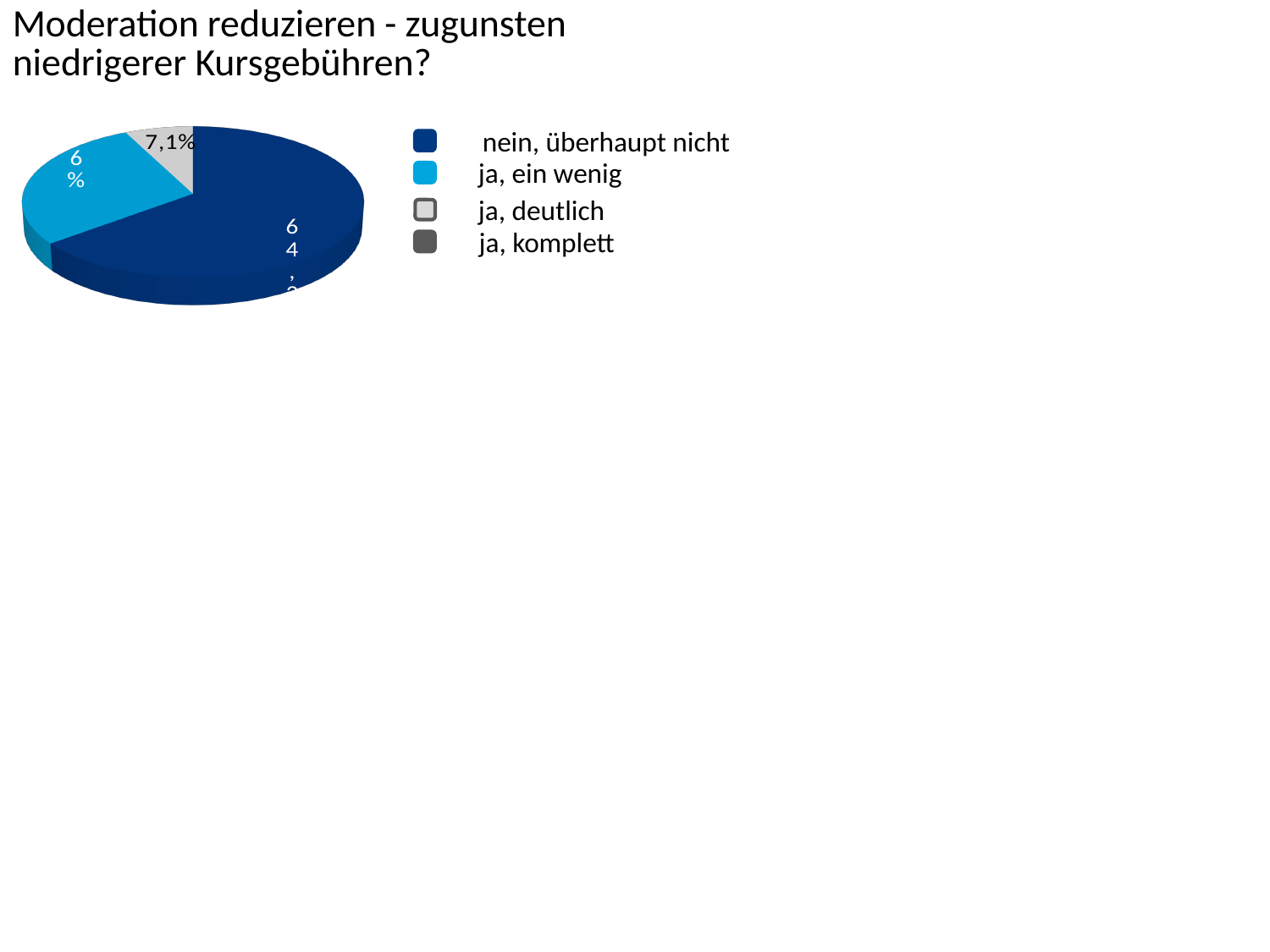
What is the title of the slide containing the pie chart? Moderation reduzieren - zugunsten niedrigerer Kursgebühren? Which category has the largest slice of the pie? nein, überhaupt nicht What colour is the 'nein, überhaupt nicht' slice in the pie chart? dark blue Which slice is larger: 'ja, ein wenig' or 'ja, deutlich'? ja, ein wenig Which slice is larger: 'nein, überhaupt nicht' or 'ja, ein wenig'? nein, überhaupt nicht What kind of chart is shown on the slide? pie chart How many entries does the legend of the pie chart list? 4 What percentage is shown for the 'ja, deutlich' slice? 7,1%